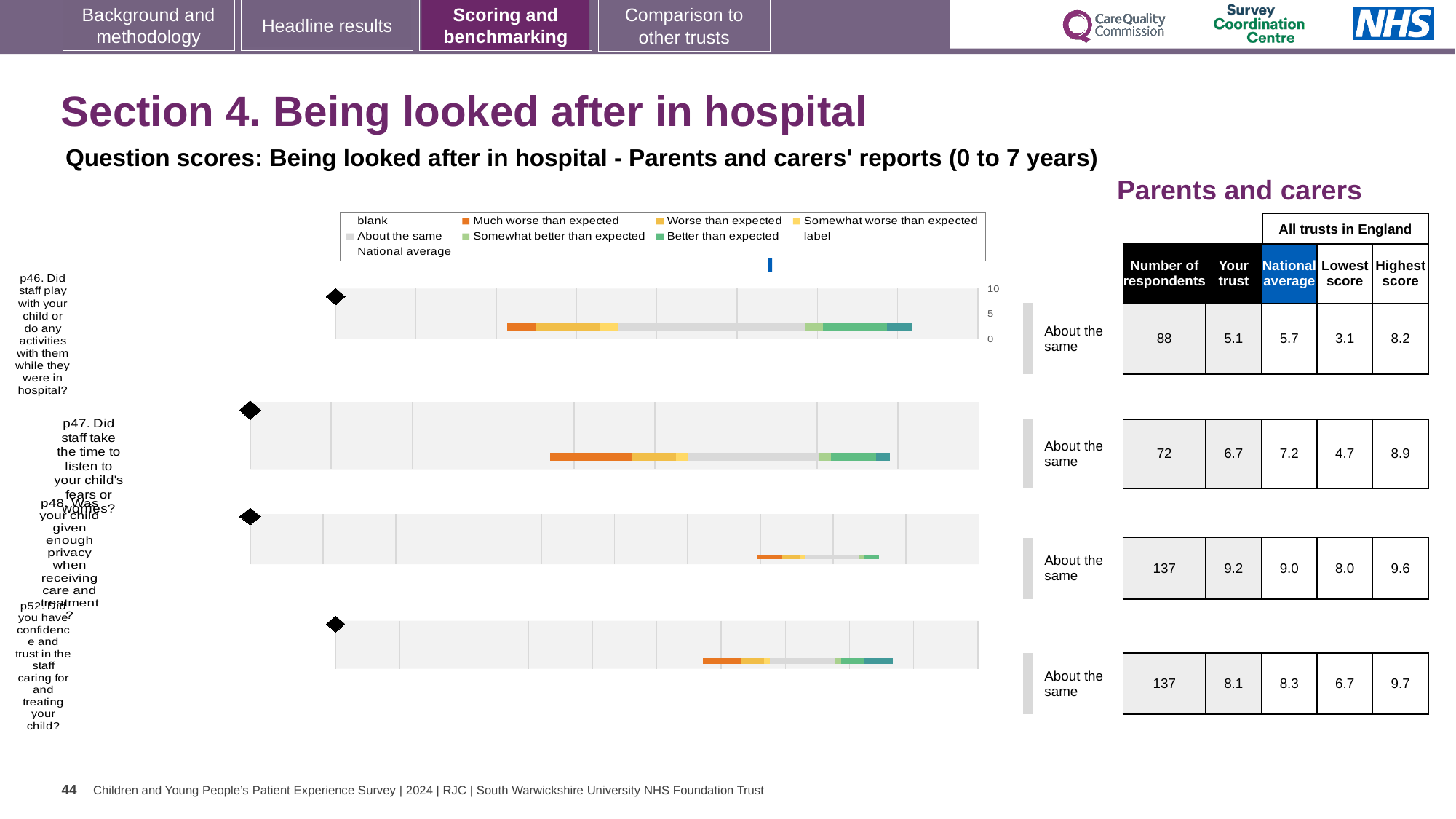
What is the lowest score across all trusts in England for question p52? 6.7 For question p47 (Did staff take the time to listen to your child's fears or worries?), what is the national average score? 7.2 For question p46 (Did staff play with your child or do any activities with them while they were in hospital?), what is the 'Your trust' score? 5.1 How many respondents answered question p48 (Was your child given enough privacy when receiving care and treatment?)? 137 For question p46, what is the difference between the highest score and the lowest score across all trusts in England? 5.1 What colour does the legend use for 'Much worse than expected'? Orange How many survey questions are plotted as bars on this slide? 4 What benchmark category is shown next to each of the four question bars? About the same For question p52 (Did you have confidence and trust in the staff caring for and treating your child?), which is larger: the 'Your trust' score or the national average? National average Which question has the highest 'Your trust' score? p48 Which question has the lowest 'Your trust' score? p46 What kind of chart is used to show the question scores on this slide? bar chart